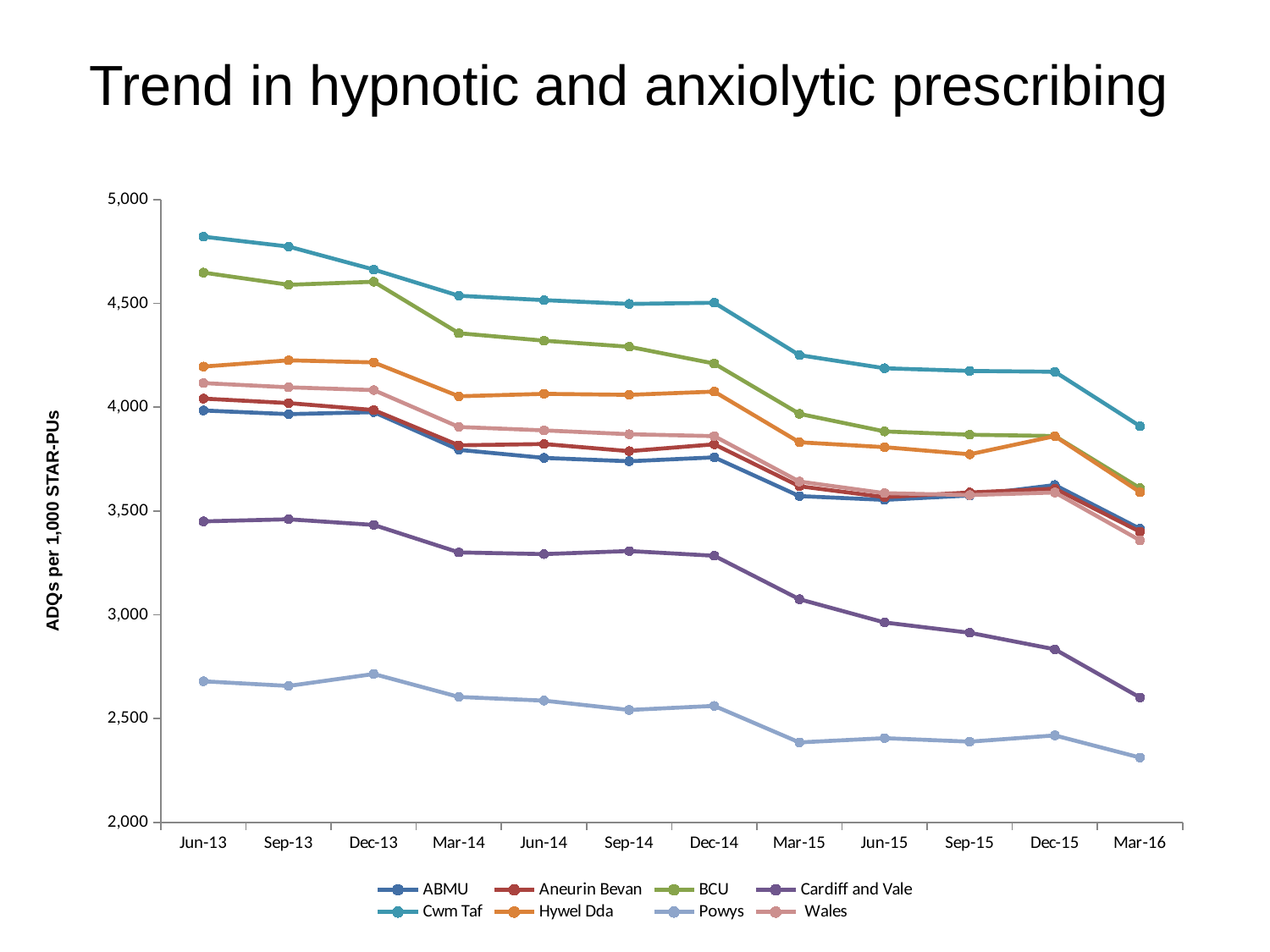
Which series has the lowest value at Mar-16? Powys What is the label on the y axis? ADQs per 1,000 STAR-PUs Is the value for Cwm Taf at Jun-13 greater or less than 4,500? greater Is the value for Powys at Mar-16 greater or less than 2,500? less Is the value for Cardiff and Vale at Jun-13 greater or less than 3,500? less How many time points are shown along the x axis? 12 Do the values for Powys generally rise or fall from Jun-13 to Mar-16? fall Which is larger at Dec-14, the value for BCU or the value for Cardiff and Vale? BCU How many series does the legend list? 8 What kind of chart is shown on the slide? line chart Which series has the highest value at Jun-13? Cwm Taf What is the title of the chart? Trend in hypnotic and anxiolytic prescribing